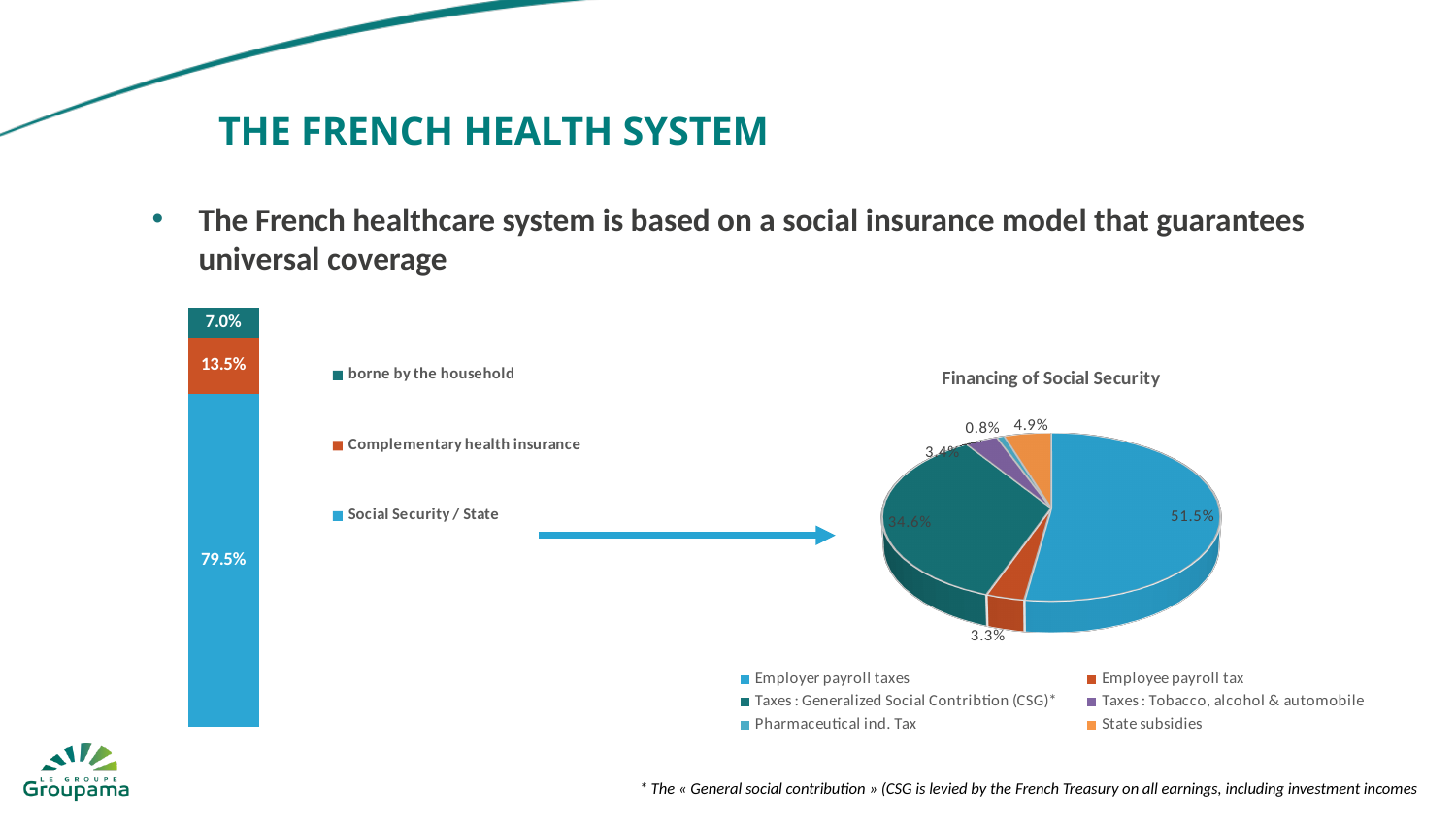
In the stacked bar chart on the left, what is the value for the segment borne by the household? 7.0% In the pie chart titled 'Financing of Social Security', what share is State subsidies? 4.9% In the pie chart titled 'Financing of Social Security', what share is Taxes : Generalized Social Contribtion (CSG)*? 34.6% In the pie chart titled 'Financing of Social Security', which source has the largest share? Employer payroll taxes In the pie chart titled 'Financing of Social Security', what is the difference between Employer payroll taxes and Taxes : Generalized Social Contribtion (CSG)*? 16.9% In the pie chart titled 'Financing of Social Security', which source has the smallest share? Pharmaceutical ind. Tax In the pie chart titled 'Financing of Social Security', what share is Employer payroll taxes? 51.5% In the stacked bar chart on the left, what is the value for Social Security / State? 79.5% What kind of chart is the chart titled 'Financing of Social Security'? Pie chart In the stacked bar chart on the left, what is the total of the three segments? 100.0% In the pie chart titled 'Financing of Social Security', how many slices are there? 6 In the stacked bar chart on the left, what is the value for Complementary health insurance? 13.5%